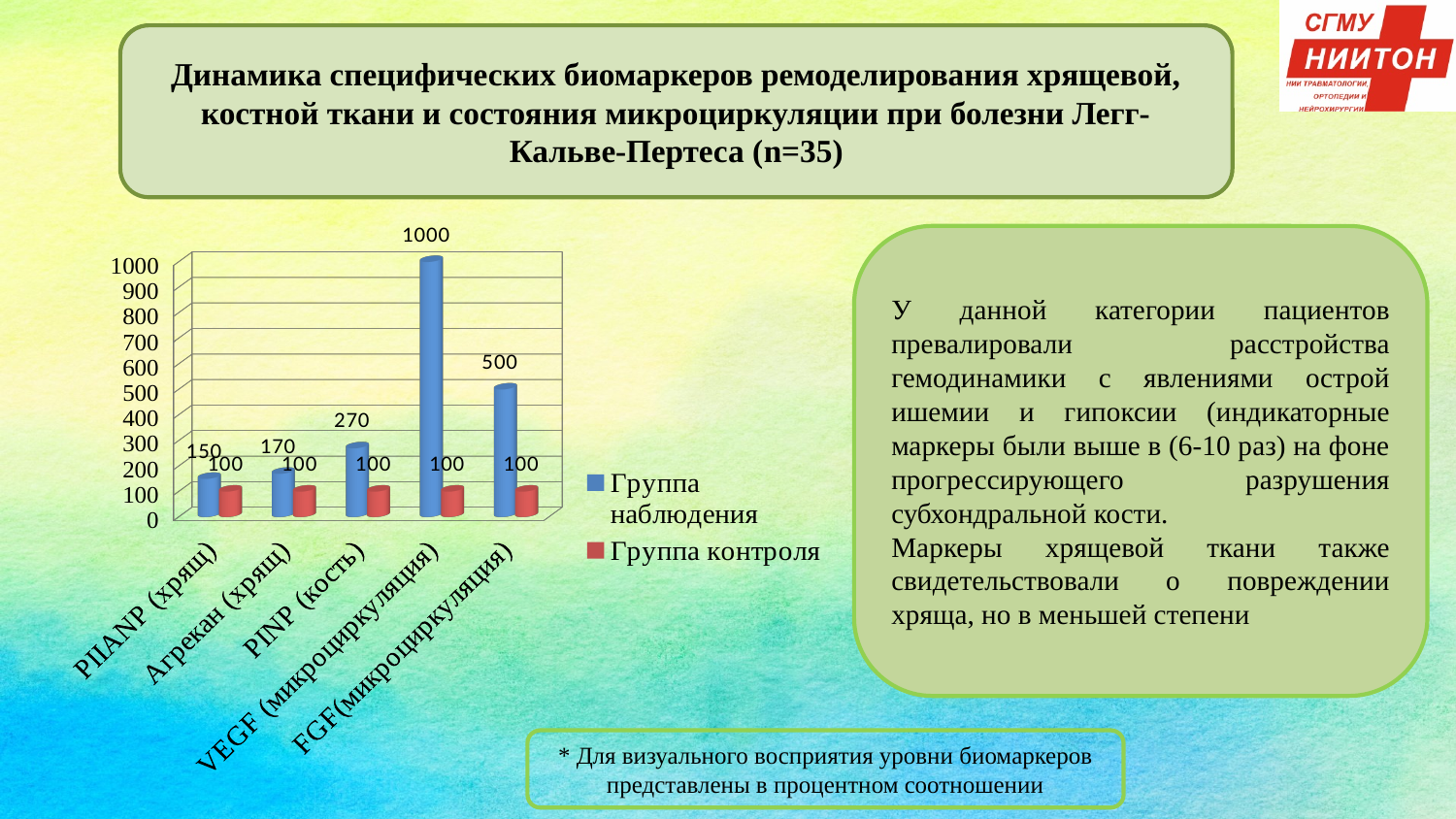
How many series does the legend list? 2 What type of chart is shown on the slide? bar chart Which is larger in the Группа наблюдения series: PINP (кость) or Агрекан (хрящ)? PINP (кость) What is the value for VEGF (микроциркуляция) in the Группа наблюдения series? 1000 Which category has the lowest value in the Группа наблюдения series? PIIANP (хрящ) Which category has the highest value in the Группа наблюдения series? VEGF (микроциркуляция) What is the difference between the Группа наблюдения values for VEGF (микроциркуляция) and FGF(микроциркуляция)? 500 Is the Группа наблюдения value for FGF(микроциркуляция) greater or less than 400? greater What is the value for PINP (кость) in the Группа наблюдения series? 270 Which colour represents the Группа контроля series? red How many categories are shown on the x axis? 5 What is the value for Агрекан (хрящ) in the Группа контроля series? 100